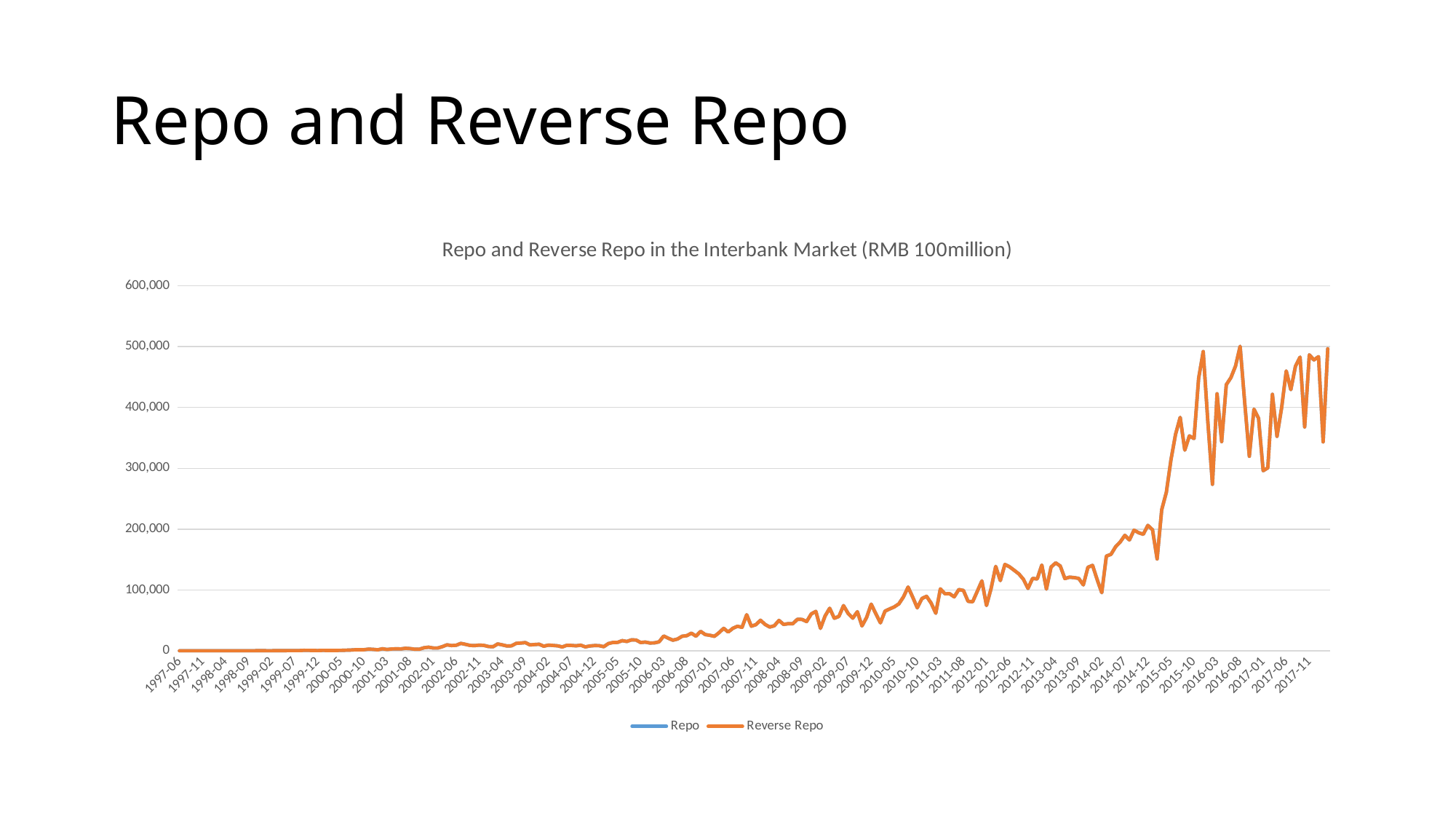
Which is larger for Reverse Repo: the value around 2016-08 or the value around 2005-05? 2016-08 How many series does the legend list? 2 What is the title of the chart? Repo and Reverse Repo in the Interbank Market (RMB 100million) Is the Reverse Repo value around 2001-03 greater or less than 100,000? less Is the Reverse Repo value around 2012-06 greater or less than 100,000? greater Is the Reverse Repo value around 2005-05 greater or less than 100,000? less Which series is drawn in orange in the legend? Reverse Repo Overall, does the Reverse Repo line rise or fall from 1997-06 to 2017-11? rise What kind of chart is shown on the slide? line chart